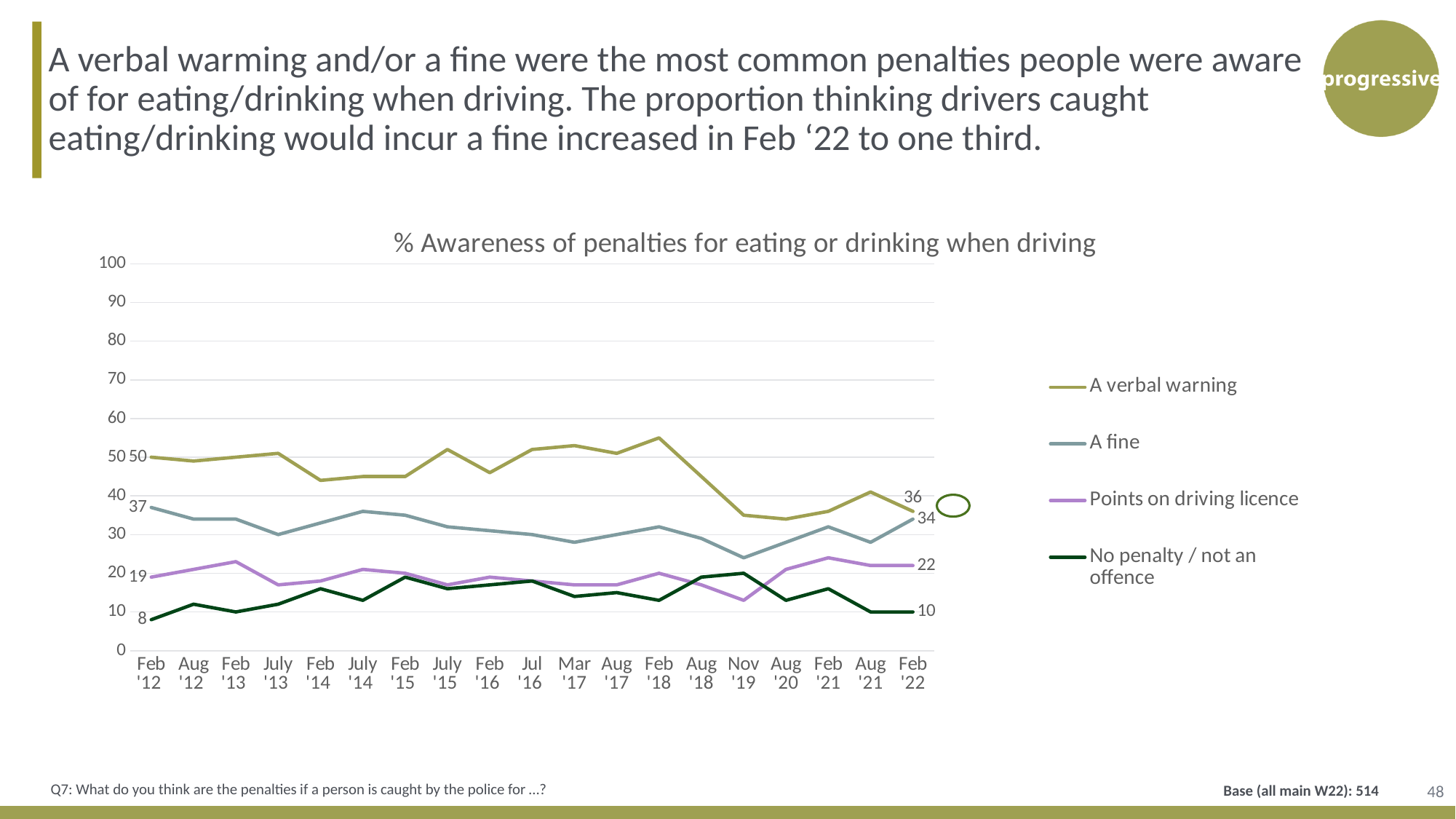
What is the difference between the 'A verbal warning' values in Feb '12 and Feb '22? 14 Which series has the highest value in Feb '12? A verbal warning Which series has the lowest value in Feb '22? No penalty / not an offence Is the value for 'A verbal warning' in Feb '18 greater or less than 50? greater What is the value for 'A verbal warning' in Feb '12? 50 How many series does the legend list? 4 What is the value for 'No penalty / not an offence' in Feb '12? 8 What is the value for 'Points on driving licence' in Feb '22? 22 What is the value for 'A fine' in Feb '22? 34 How many time points are shown on the x axis? 19 What is the title of the chart? % Awareness of penalties for eating or drinking when driving What kind of chart is shown on the slide? line chart